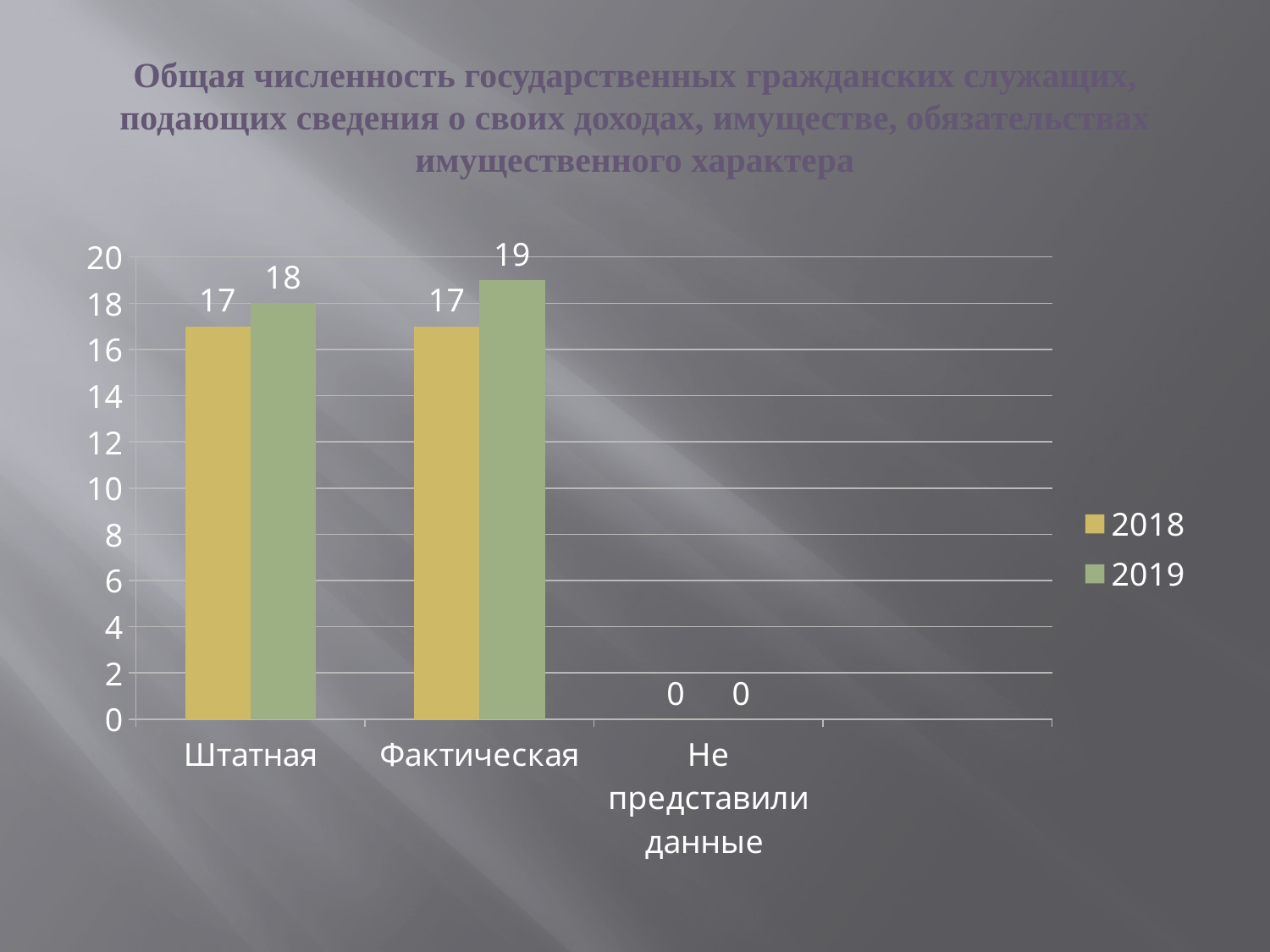
What is the value for Штатная in 2018? 17 What is the difference between the 2019 and 2018 values for Фактическая? 2 What is the value for Штатная in 2019? 18 Which category has the highest value in the 2019 series? Фактическая What is the value for Фактическая in 2019? 19 How many series does the legend list? 2 Which category has the lowest value in the 2018 series? Не представили данные What is the value for Не представили данные in 2018? 0 Which series is shown in green in the legend? 2019 What kind of chart is shown on the slide? bar chart How many categories are shown on the x axis? 3 Which is larger: the 2019 value for Штатная or the 2019 value for Фактическая? Фактическая